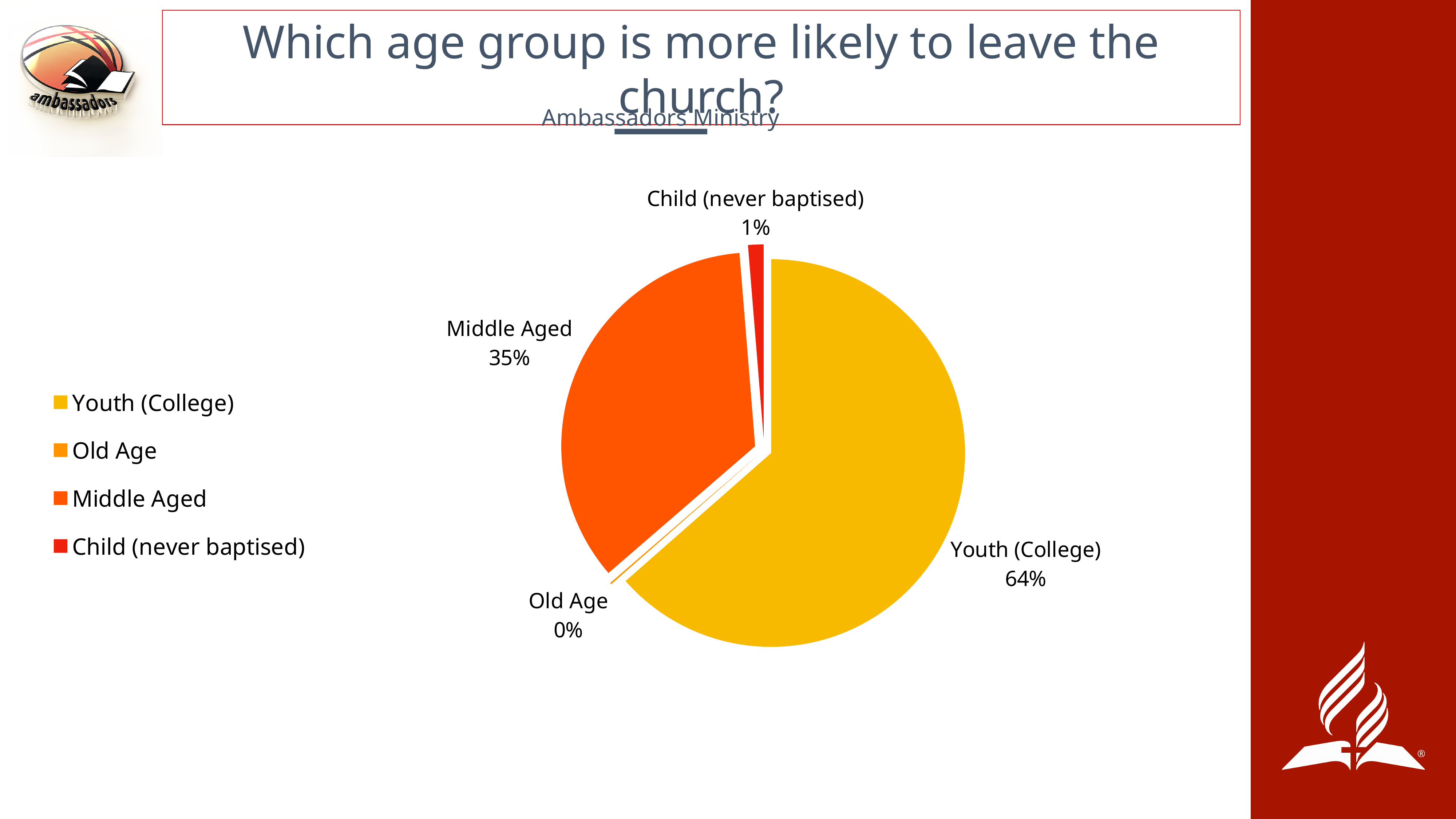
Which age group has the largest slice of the pie? Youth (College) What colour is the Youth (College) slice? yellow What is the value shown for Child (never baptised)? 1% What is the difference between the Youth (College) share and the Middle Aged share? 29% Which is larger, the share for Middle Aged or the share for Child (never baptised)? Middle Aged Which age group has the smallest slice of the pie? Old Age What share of the pie does Youth (College) represent? 64% How many categories does the pie chart show? 4 What is the value shown for Old Age? 0% What share of the pie does Middle Aged represent? 35% What kind of chart is shown on the slide? pie chart How many entries does the legend list? 4